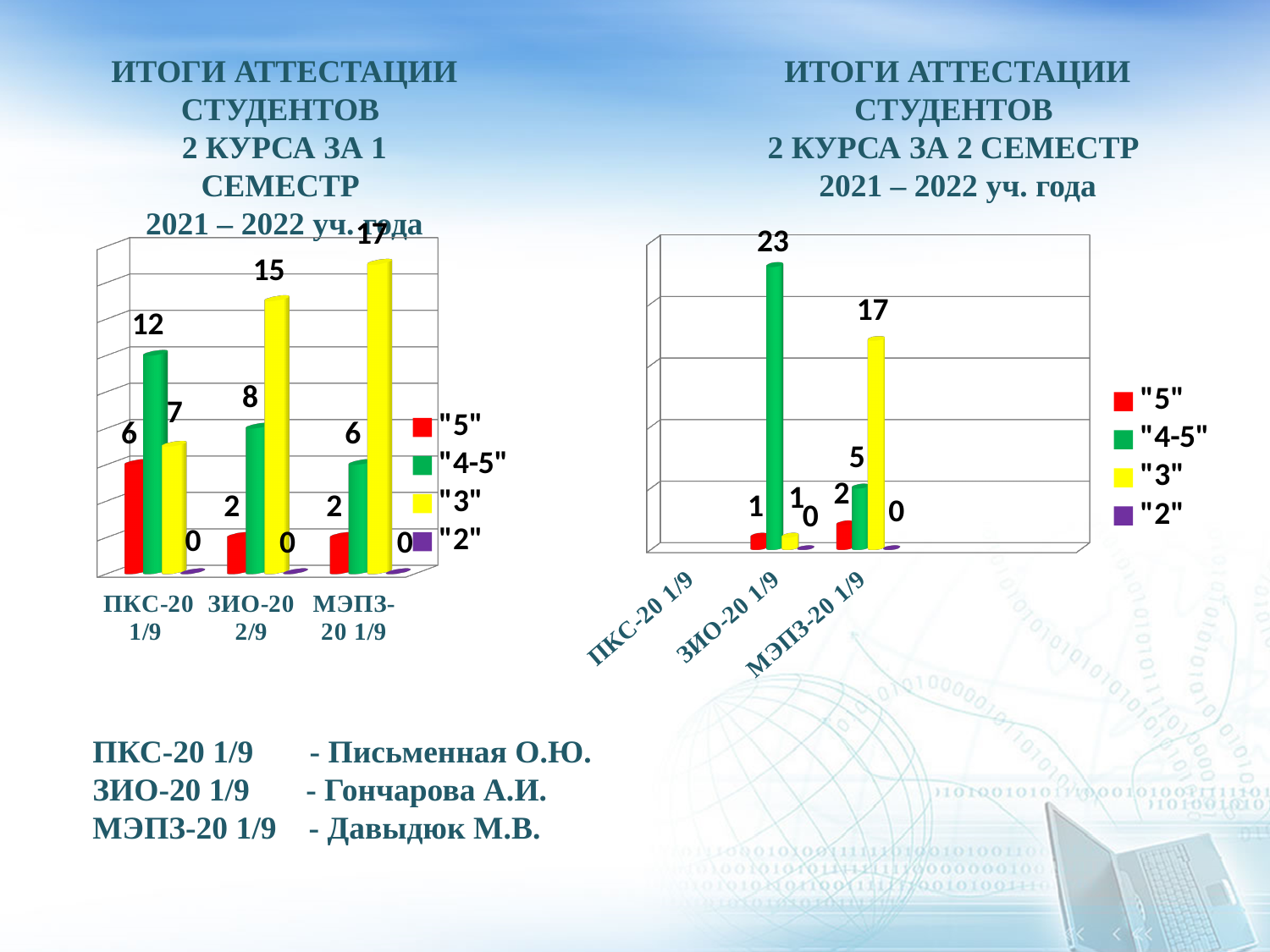
On the left chart (1 семестр), how many groups are shown on the x axis? 3 On the left chart (1 семестр), what is the difference between the "3" values for ЗИО-20 2/9 and ПКС-20 1/9? 8 On the left chart (1 семестр), what is the value of "5" for ЗИО-20 2/9? 2 How many series does the legend of the right chart (2 семестр) list? 4 On the left chart (1 семестр), which group has the lowest value for "4-5"? МЭПЗ-20 1/9 On the left chart (1 семестр), what is the value of "3" for МЭПЗ-20 1/9? 17 On the left chart (1 семестр), which group has the highest value for "3"? МЭПЗ-20 1/9 On the left chart (1 семестр), what is the total of all four series for ЗИО-20 2/9? 25 On the left chart (1 семестр), what is the value of "4-5" for ПКС-20 1/9? 12 What type of chart is the right chart (2 семестр)? bar chart On the right chart (2 семестр), what is the highest value labelled on any bar? 23 On the left chart (1 семестр), which is larger for ПКС-20 1/9: the "5" value or the "3" value? "3"